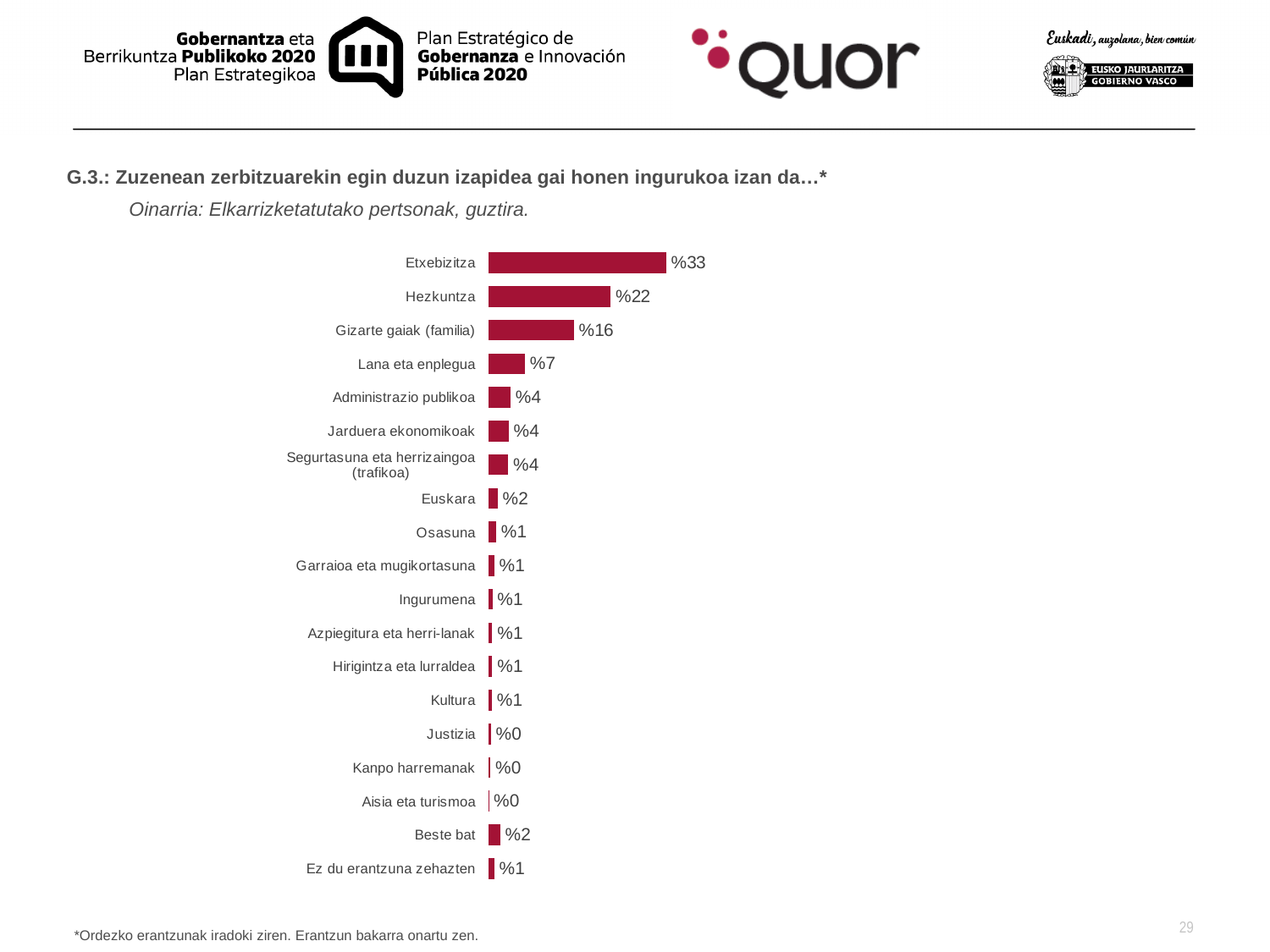
Which is larger, the value for Lana eta enplegua or the value for Administrazio publikoa? Lana eta enplegua What is the value for Justizia? %0 What is the value for Hezkuntza? %22 What is the value for Gizarte gaiak (familia)? %16 What is the value for Lana eta enplegua? %7 What is the value for Beste bat? %2 What is the difference between the values for Hezkuntza and Gizarte gaiak (familia)? %6 How many categories are shown in the chart? 19 Which category has the highest value? Etxebizitza What is the difference between the values for Etxebizitza and Hezkuntza? %11 What is the value for Etxebizitza? %33 What kind of chart is shown on the slide? Bar chart